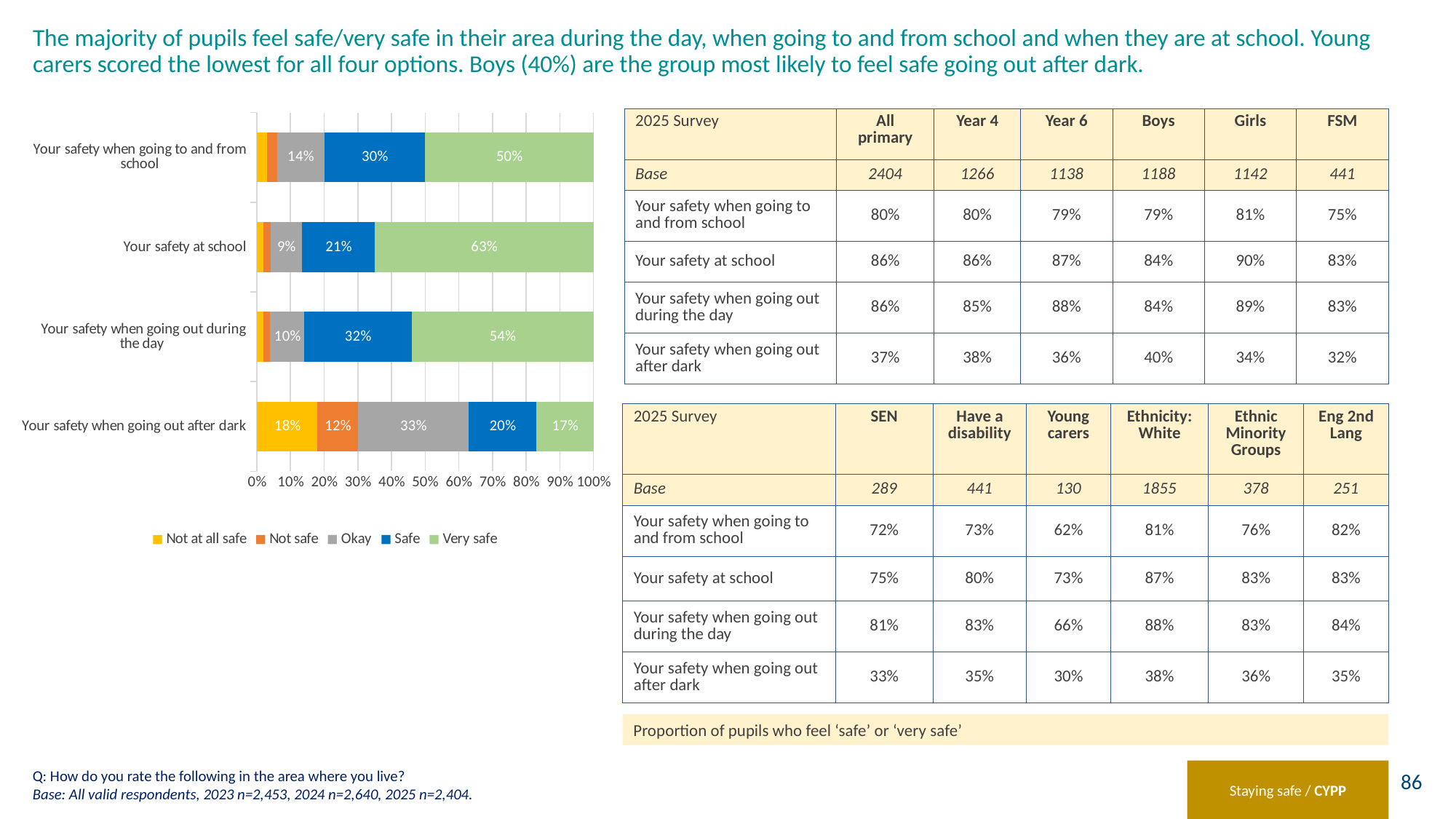
In the chart, which category has the lowest 'Very safe' percentage? Your safety when going out after dark In the chart, what is the 'Safe' value for 'Your safety when going out during the day'? 32% In the chart, which category has the highest 'Very safe' percentage? Your safety at school In the chart, what percentage of pupils said 'Very safe' for 'Your safety at school'? 63% In the chart, what is the 'Okay' value for 'Your safety when going to and from school'? 14% In the chart, how many percentage points higher is the 'Very safe' value for 'Your safety at school' than for 'Your safety when going to and from school'? 13 percentage points How many categories are shown on the chart's vertical axis? 4 How many series does the chart's legend list? 5 In the chart, which has the larger 'Safe' value: 'Your safety when going out during the day' or 'Your safety when going to and from school'? Your safety when going out during the day What kind of chart is shown on the slide? Stacked bar chart In the chart, what percentage of pupils said 'Not at all safe' for 'Your safety when going out after dark'? 18% In the chart, is the 'Not safe' value for 'Your safety when going to and from school' greater or less than 10%? less